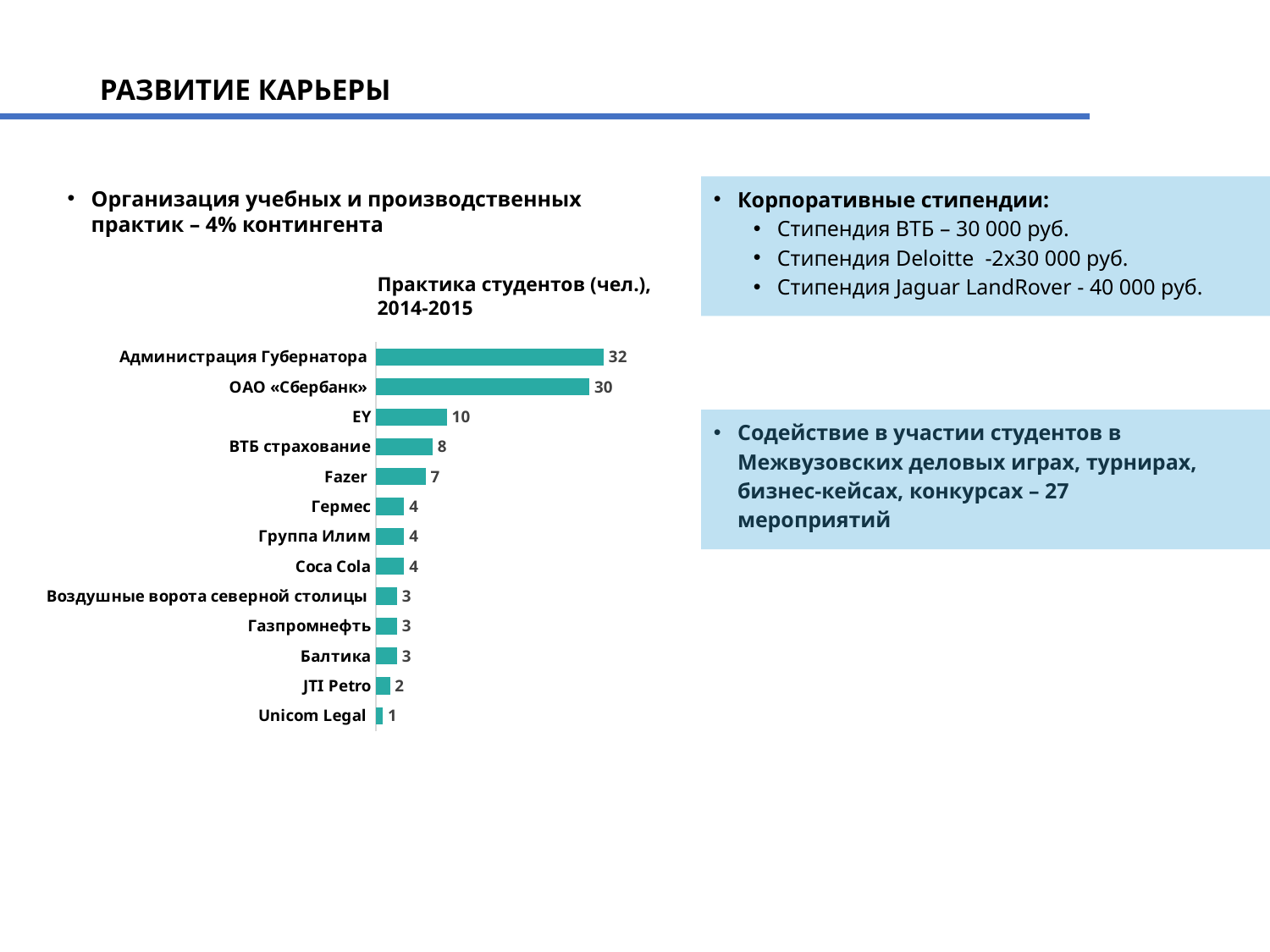
What type of chart is shown on the slide? Bar chart Which organization has the lowest number of students? Unicom Legal What is the value for EY? 10 What is the difference between Администрация Губернатора and ОАО «Сбербанк»? 2 How many organizations are shown in the chart? 13 What is the difference between EY and JTI Petro? 8 What is the value for ОАО «Сбербанк»? 30 What is the title of the chart? Практика студентов (чел.), 2014-2015 How many students did practice at Администрация Губернатора? 32 Which organization has the highest number of students? Администрация Губернатора Which is larger, the value for ВТБ страхование or the value for Fazer? ВТБ страхование What is the value for Fazer? 7